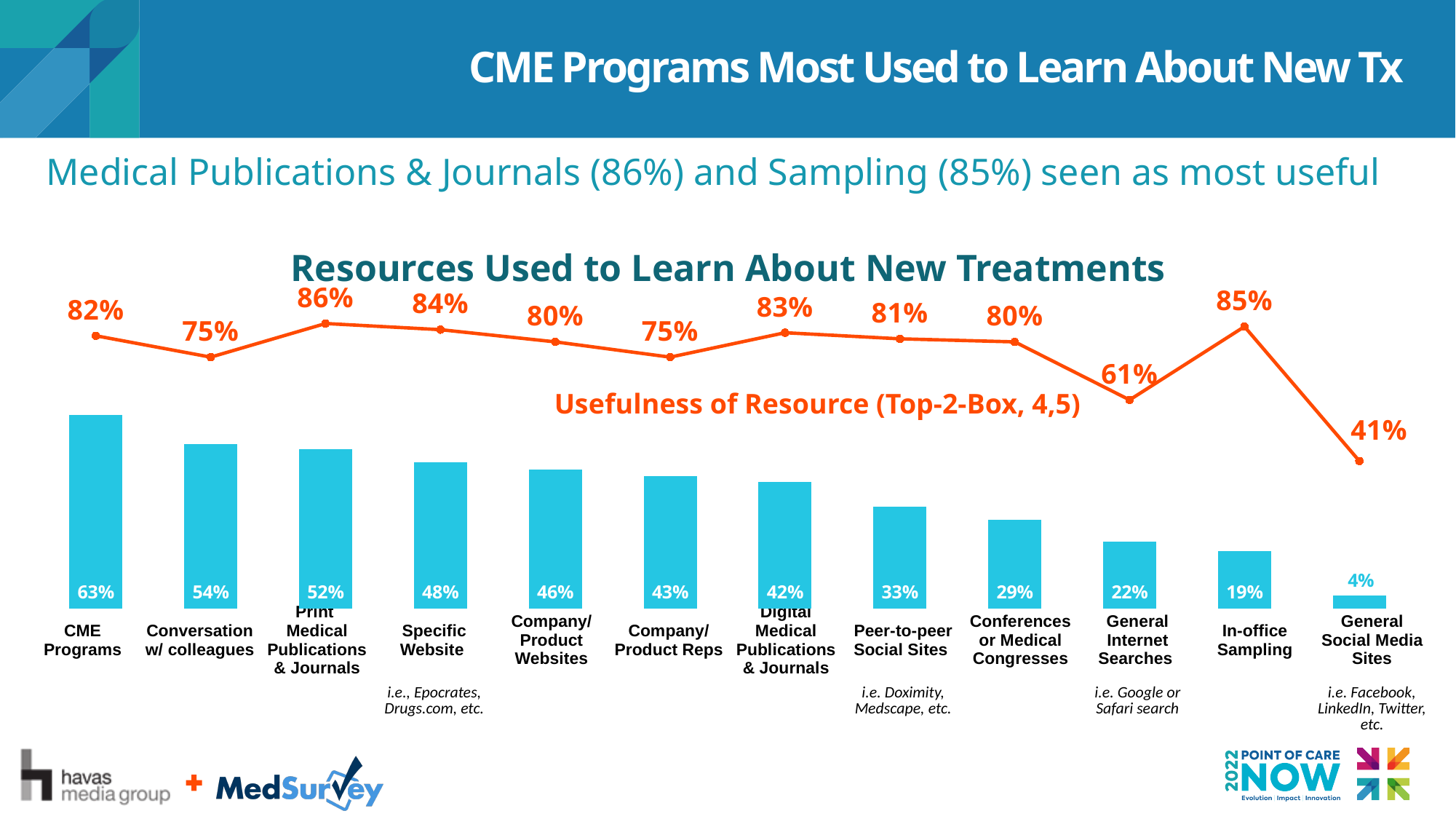
What is the title of the chart? Resources Used to Learn About New Treatments What kind of chart is shown on the slide? Combined bar and line chart Which has a higher usefulness value on the line: In-office Sampling or General Internet Searches? In-office Sampling How many resource categories are shown on the x axis? 12 What is the usefulness value shown on the line for General Social Media Sites? 41% Which resource has the lowest usefulness value on the line? General Social Media Sites What percentage of respondents use CME Programs to learn about new treatments, according to the bar? 63% What is the bar value for General Internet Searches? 22% Do the bar values rise or fall moving from left to right along the x axis? Fall What is the usefulness (Top-2-Box) value shown on the line for Print Medical Publications & Journals? 86% What is the difference between the bar values for CME Programs and Conversation w/ colleagues? 9% Which resource has the highest bar value for resources used? CME Programs